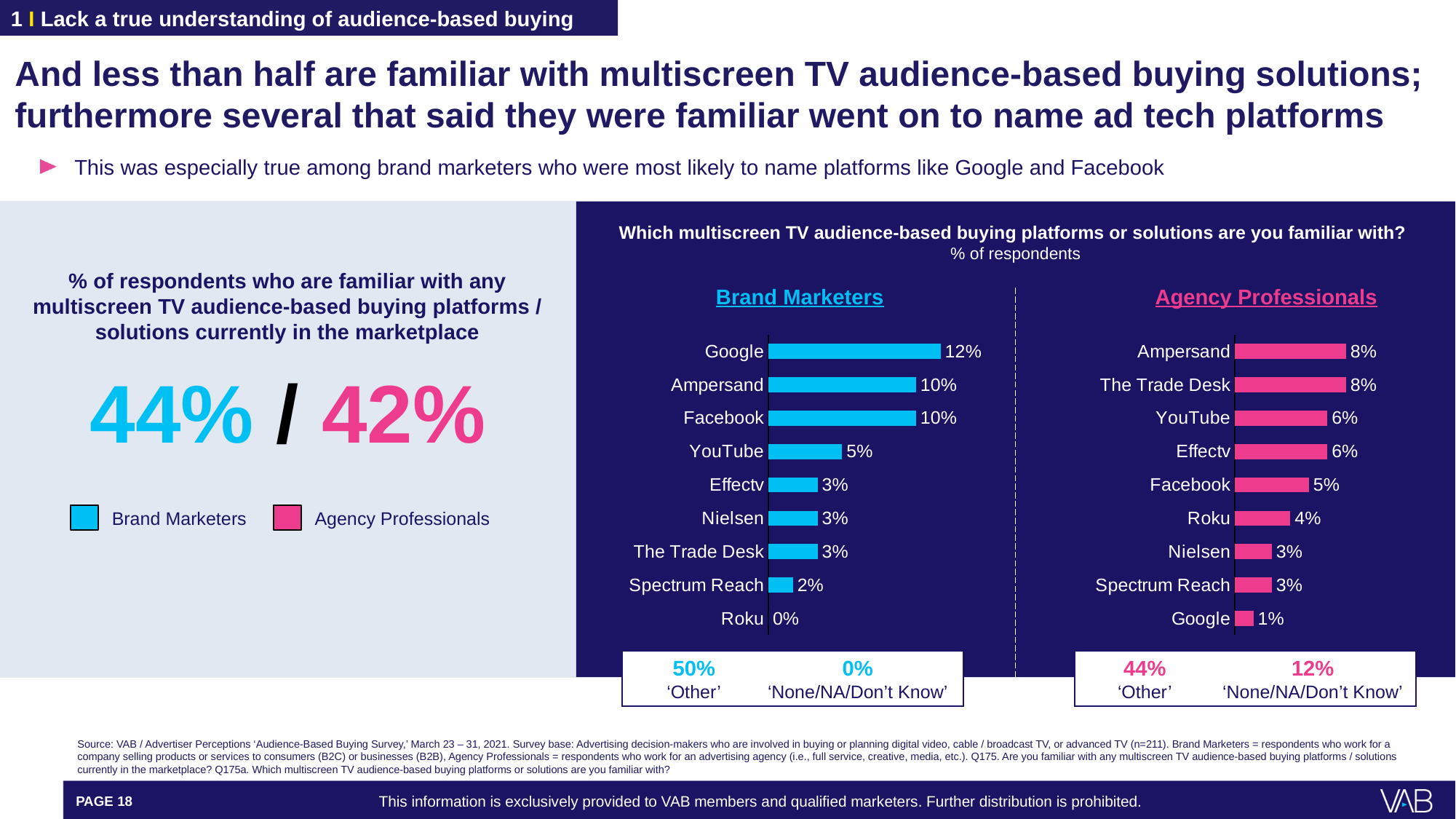
In the Agency Professionals chart, what is the difference between the values for Ampersand and Facebook? 3% In the Agency Professionals chart, which is larger, the value for YouTube or the value for Nielsen? YouTube What colour are the bars in the Agency Professionals chart? Pink In the Brand Marketers chart, which platform has the highest percentage? Google In the Brand Marketers chart, which platform has the lowest percentage? Roku In the Agency Professionals chart, which platform has the lowest percentage? Google In the Agency Professionals chart, what percentage of respondents are familiar with Roku? 4% What type of chart is used for the Agency Professionals data? Bar chart How many platforms are listed in the Brand Marketers chart? 9 In the Brand Marketers chart, what percentage of respondents answered 'Other'? 50% In the Brand Marketers chart, what percentage of respondents are familiar with Google? 12% In the Brand Marketers chart, what is the difference between the values for Google and YouTube? 7%